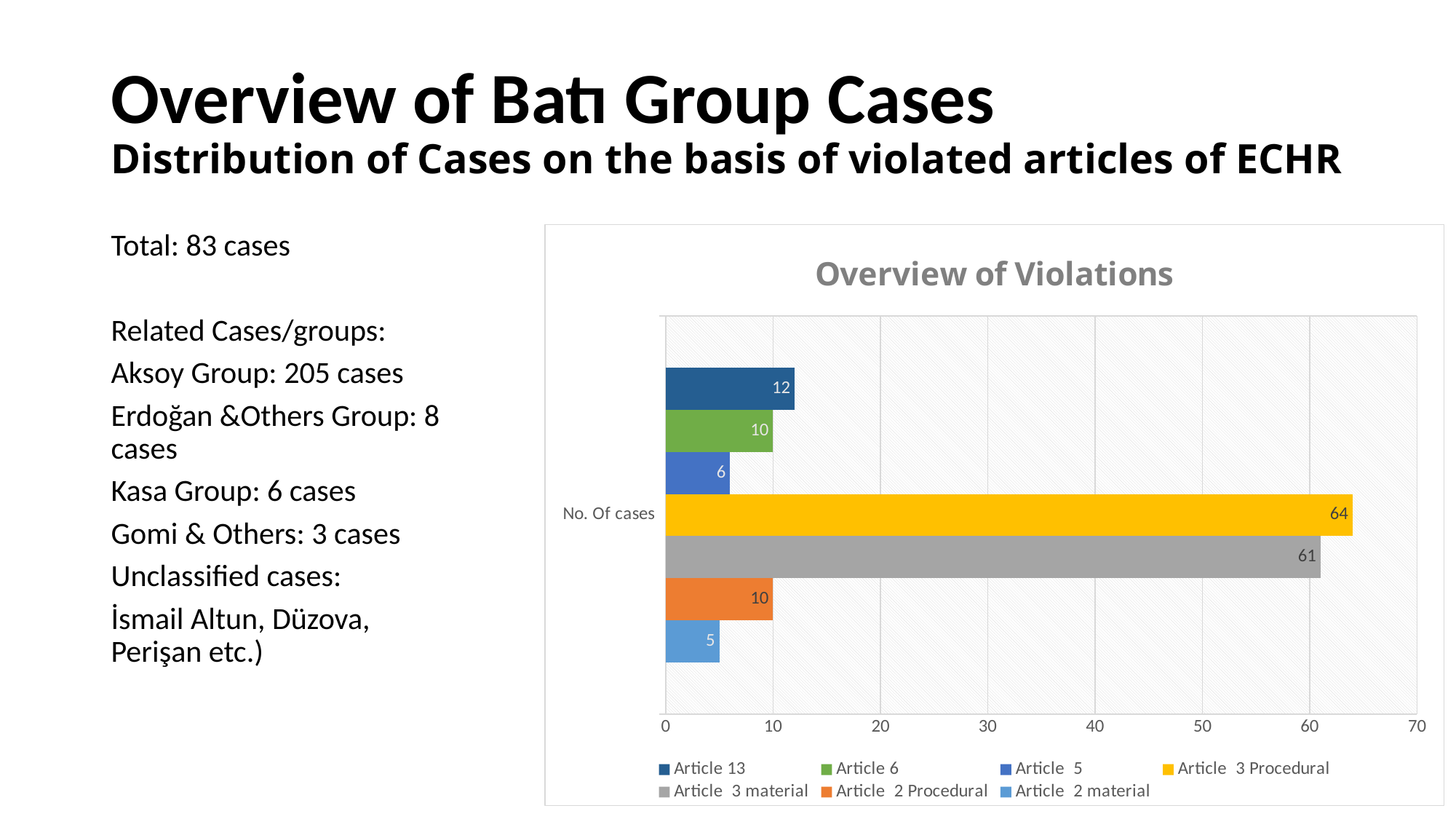
What is the number of cases for Article 3 Procedural? 64 Which article has the highest number of cases? Article 3 Procedural What is the number of cases for Article 2 material? 5 What is the title of the chart? Overview of Violations Which has more cases, Article 13 or Article 6? Article 13 What is the difference between the number of cases for Article 3 Procedural and Article 3 material? 3 What is the number of cases for Article 5? 6 How many series does the legend list? 7 What kind of chart is shown on the slide? bar chart What is the number of cases for Article 3 material? 61 Which article has the lowest number of cases? Article 2 material What is the number of cases for Article 13? 12